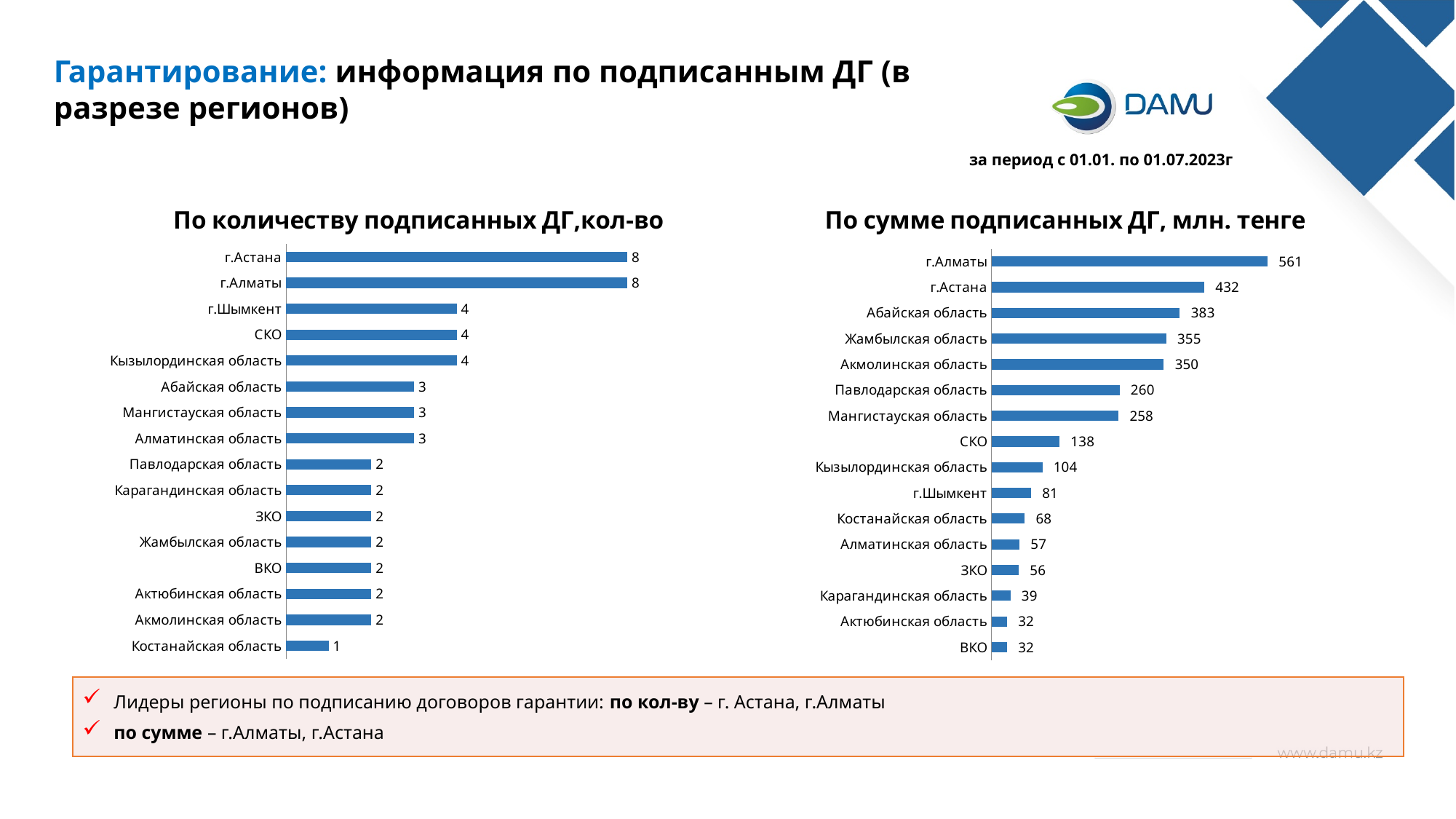
In the chart 'По сумме подписанных ДГ, млн. тенге', which is larger: Павлодарская область or СКО? Павлодарская область In the chart 'По количеству подписанных ДГ,кол-во', what is the value for г.Шымкент? 4 In the chart 'По количеству подписанных ДГ,кол-во', how many regions are shown? 16 In the chart 'По сумме подписанных ДГ, млн. тенге', what is the value for Костанайская область? 68 What period is stated on the slide for the data? с 01.01. по 01.07.2023г In the chart 'По сумме подписанных ДГ, млн. тенге', which region has the highest value? г.Алматы What type of chart is 'По сумме подписанных ДГ, млн. тенге'? Bar chart In the chart 'По сумме подписанных ДГ, млн. тенге', what is the value for Жамбылская область? 355 In the chart 'По сумме подписанных ДГ, млн. тенге', what is the difference between г.Алматы and г.Астана? 129 In the chart 'По сумме подписанных ДГ, млн. тенге', how many regions are shown? 16 In the chart 'По количеству подписанных ДГ,кол-во', which region has the lowest value? Костанайская область In the chart 'По количеству подписанных ДГ,кол-во', what is the difference between г.Астана and Абайская область? 5